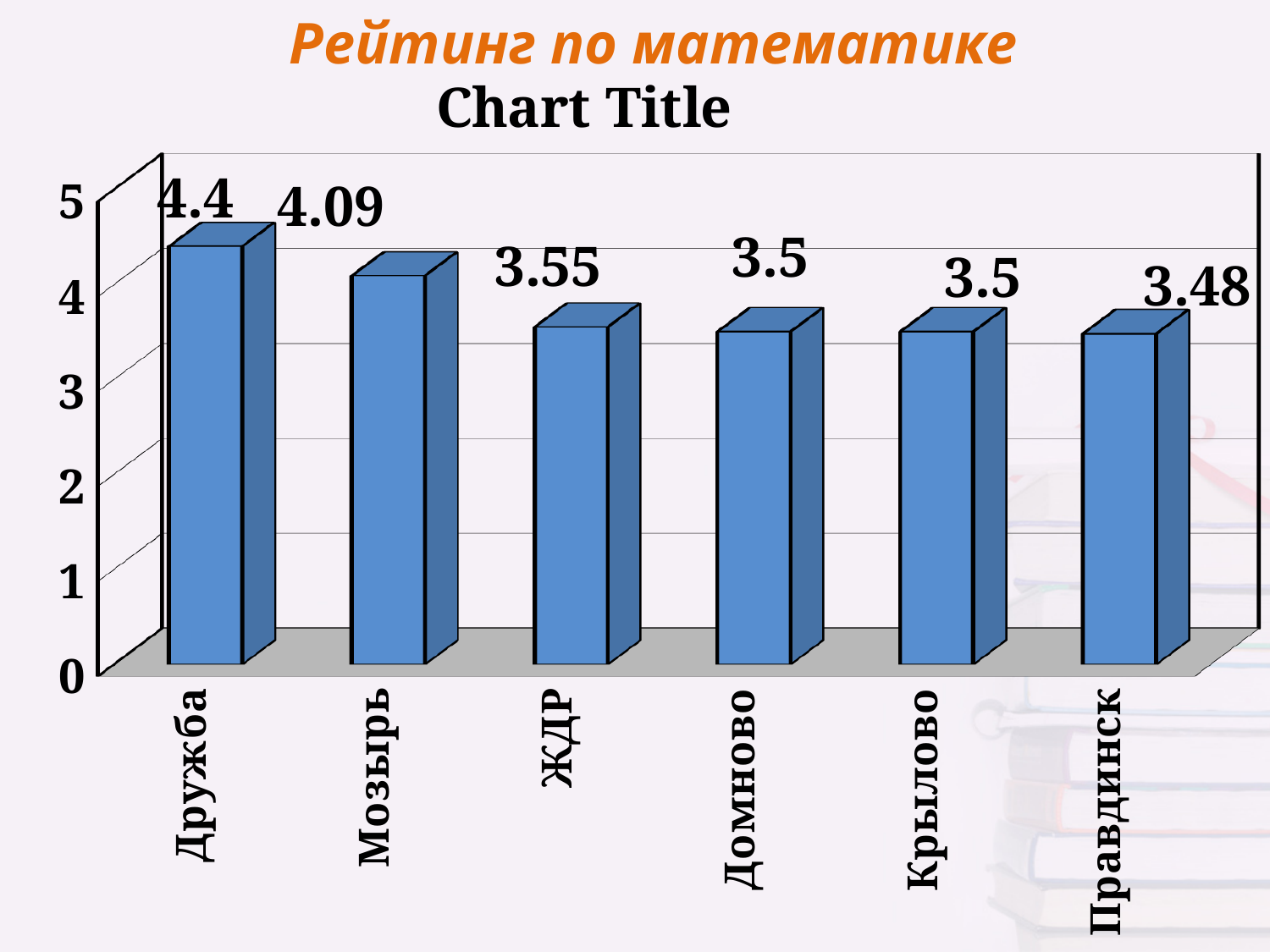
What is the value for Мозырь? 4.09 What kind of chart is this? bar chart Which category has the highest value? Дружба What is the value for ЖДР? 3.55 What is the slide's heading above the chart? Рейтинг по математике What is the value for Правдинск? 3.48 How many categories are shown on the x axis? 6 Which category has the lowest value? Правдинск What is the difference between the values for ЖДР and Правдинск? 0.07 What is the value for Дружба? 4.4 What is the difference between the values for Дружба and Мозырь? 0.31 Which is larger, the value for Мозырь or the value for Домново? Мозырь